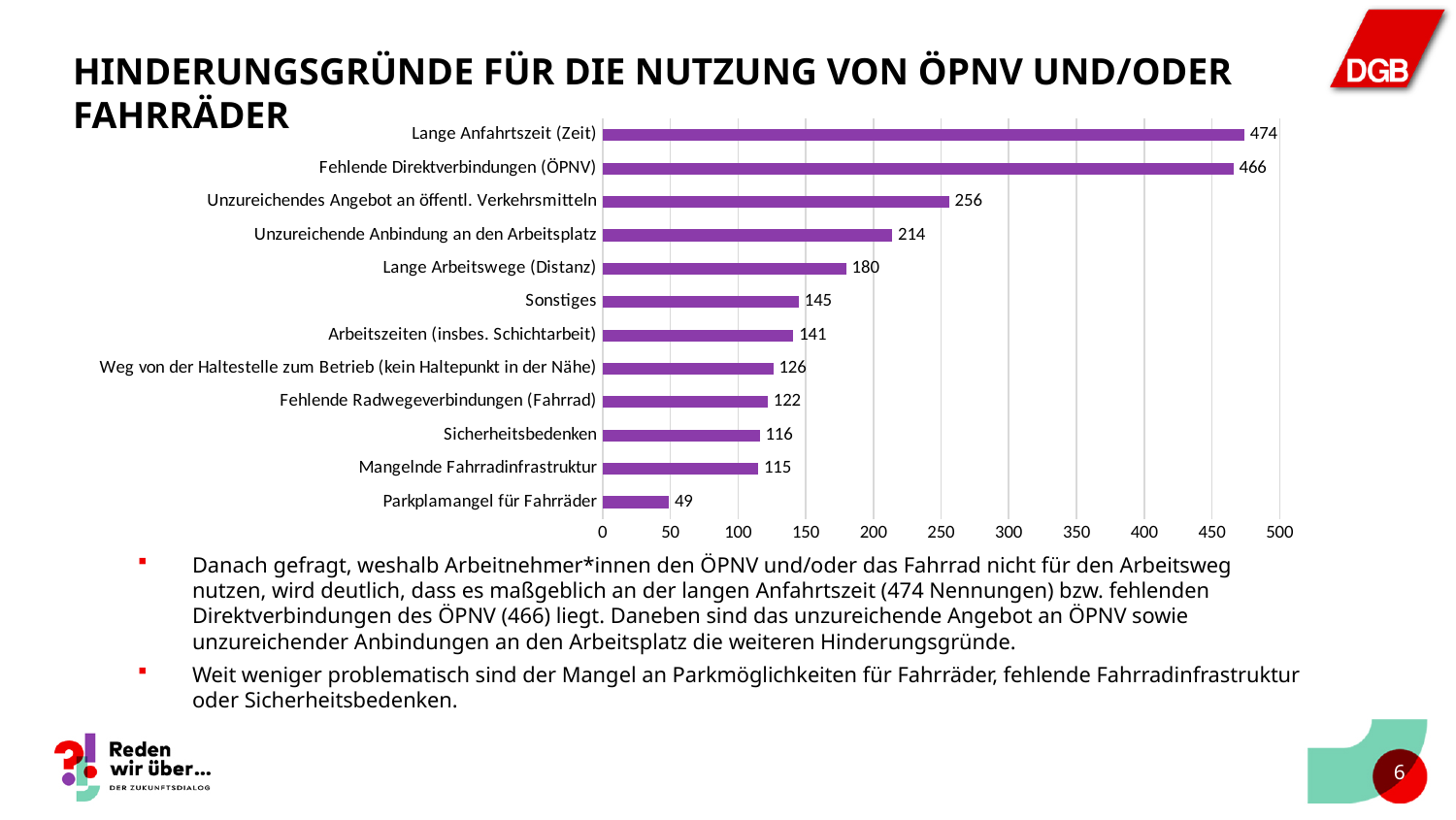
What is the value for "Sonstiges"? 145 Which category has the lowest value? Parkplamangel für Fahrräder What is the value for "Parkplamangel für Fahrräder"? 49 How many categories are shown in the chart? 12 What is the value for "Lange Anfahrtszeit (Zeit)"? 474 Which category has the highest value? Lange Anfahrtszeit (Zeit) Which is larger: "Lange Arbeitswege (Distanz)" or "Arbeitszeiten (insbes. Schichtarbeit)"? Lange Arbeitswege (Distanz) What kind of chart is shown on the slide? Bar chart What is the difference between "Lange Anfahrtszeit (Zeit)" and "Fehlende Direktverbindungen (ÖPNV)"? 8 What is the difference between "Unzureichendes Angebot an öffentl. Verkehrsmitteln" and "Unzureichende Anbindung an den Arbeitsplatz"? 42 What is the maximum value shown on the horizontal axis? 500 Is the value for "Fehlende Direktverbindungen (ÖPNV)" greater or less than 400? greater